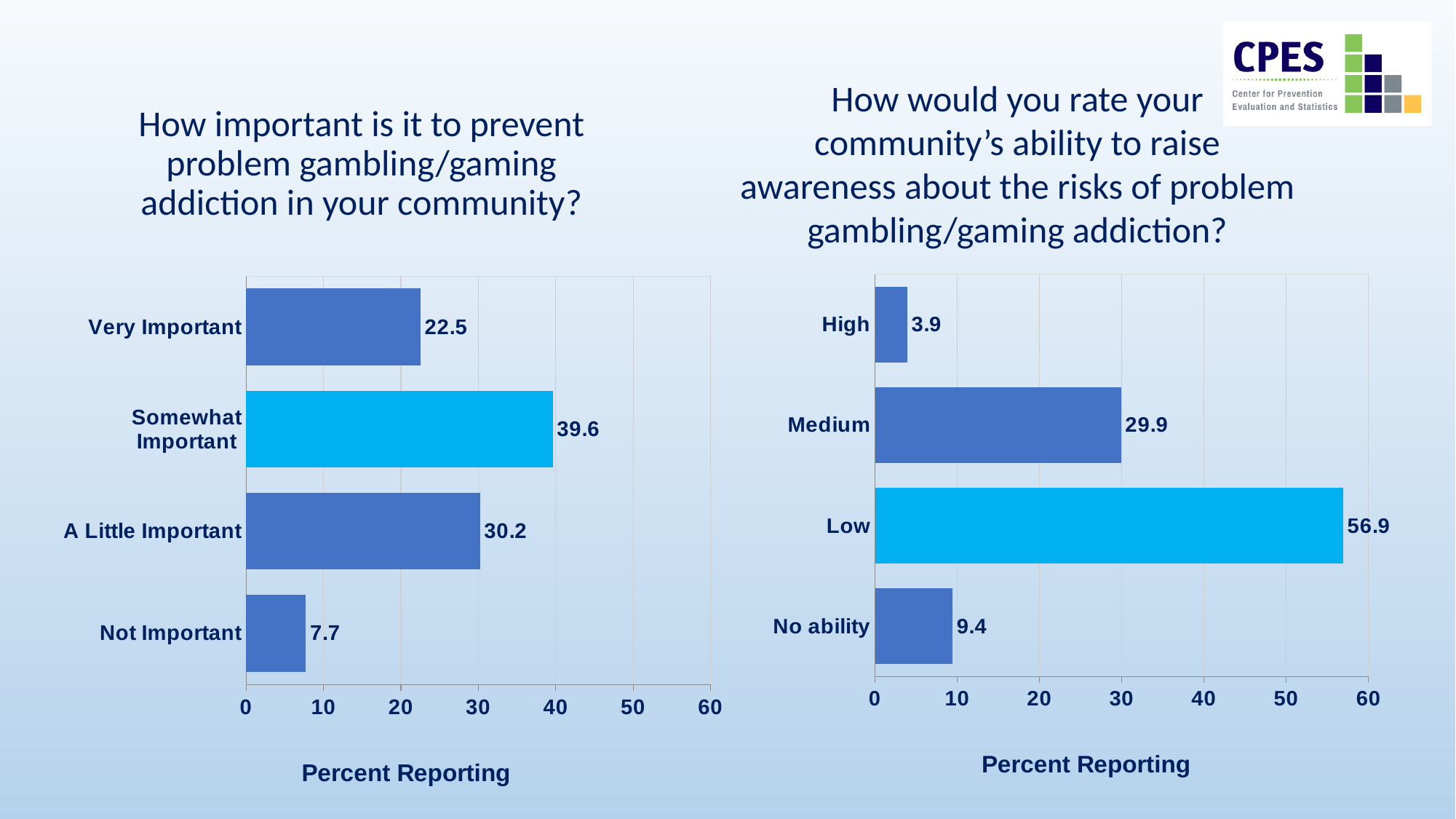
In the right chart (How would you rate your community's ability to raise awareness about the risks of problem gambling/gaming addiction?), what is the value for Low? 56.9 What kind of chart is the right chart (How would you rate your community's ability to raise awareness about the risks of problem gambling/gaming addiction?)? Bar chart In the left chart (How important is it to prevent problem gambling/gaming addiction in your community?), what is the difference between A Little Important and Very Important? 7.7 In the left chart (How important is it to prevent problem gambling/gaming addiction in your community?), what is the value for Not Important? 7.7 In the right chart (How would you rate your community's ability to raise awareness about the risks of problem gambling/gaming addiction?), which category has the lowest value? High In the left chart (How important is it to prevent problem gambling/gaming addiction in your community?), which category has the highest value? Somewhat Important In the left chart (How important is it to prevent problem gambling/gaming addiction in your community?), what is the value for Somewhat Important? 39.6 In the right chart (How would you rate your community's ability to raise awareness about the risks of problem gambling/gaming addiction?), what is the value for Medium? 29.9 What is the x-axis title of the left chart (How important is it to prevent problem gambling/gaming addiction in your community?)? Percent Reporting In the right chart (How would you rate your community's ability to raise awareness about the risks of problem gambling/gaming addiction?), which is larger, No ability or High? No ability In the right chart (How would you rate your community's ability to raise awareness about the risks of problem gambling/gaming addiction?), what is the difference between Low and Medium? 27.0 In the left chart (How important is it to prevent problem gambling/gaming addiction in your community?), how many categories are shown? 4